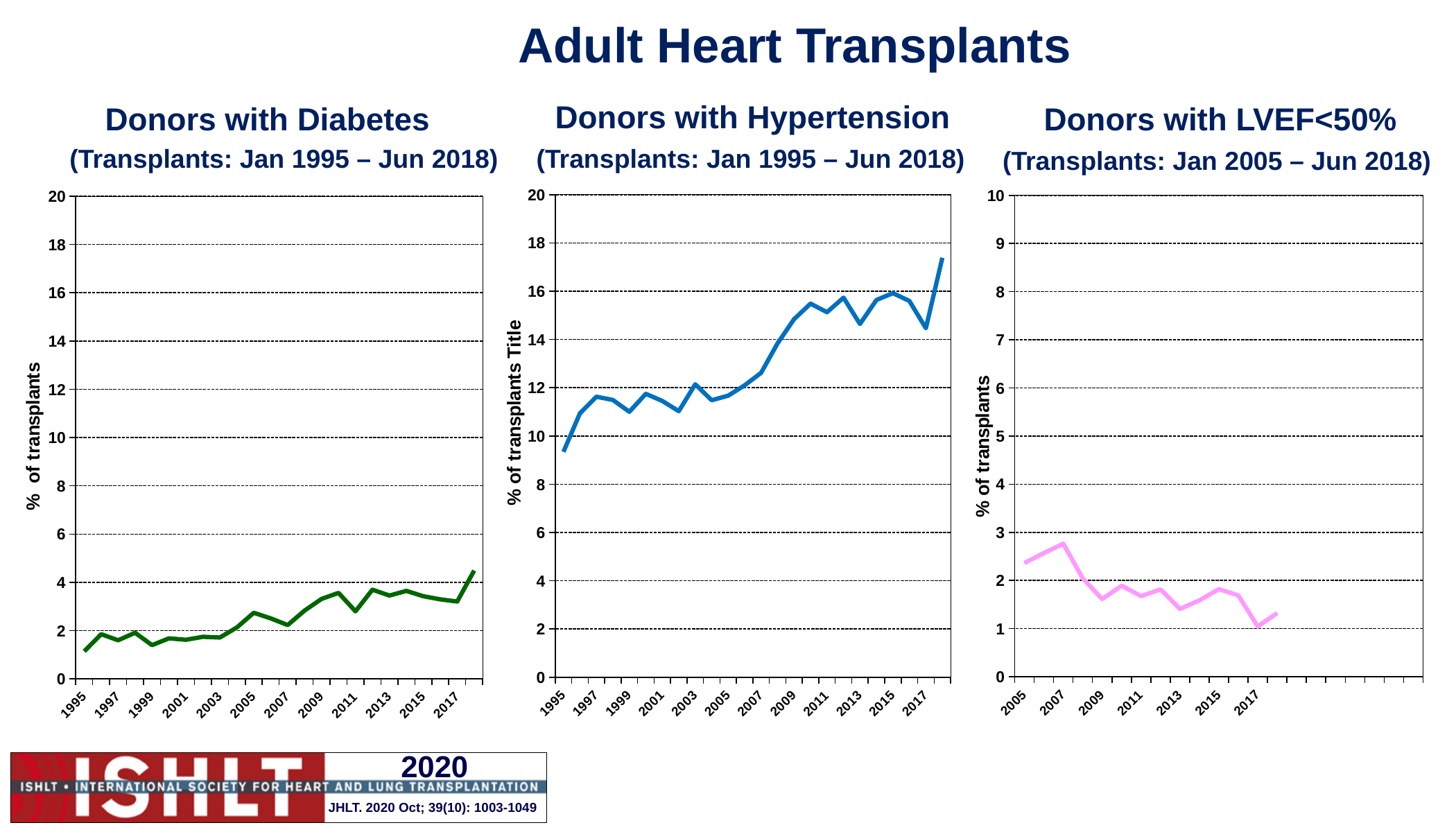
What type of chart is the 'Donors with Diabetes' chart? line chart In the 'Donors with Diabetes' chart, is the value for 1995 greater or less than 2? less What is the transplant date range given in the subtitle of the 'Donors with LVEF<50%' chart? Jan 2005 – Jun 2018 In the 'Donors with LVEF<50%' chart, is the value for 2017 greater or less than 2? less How many charts are shown on the slide? 3 In the 'Donors with Hypertension' chart, do the values generally rise or fall from 1995 to 2018? rise In the 'Donors with Hypertension' chart, which year has the lowest value? 1995 In the 'Donors with Hypertension' chart, is the value for 2018 greater or less than 16? greater In the 'Donors with LVEF<50%' chart, which year has the highest value? 2007 In the 'Donors with Hypertension' chart, which year has the highest value? 2018 In the 'Donors with Hypertension' chart, which is larger, the value for 2003 or the value for 2009? 2009 In the 'Donors with LVEF<50%' chart, do the values generally rise or fall from 2005 to 2018? fall